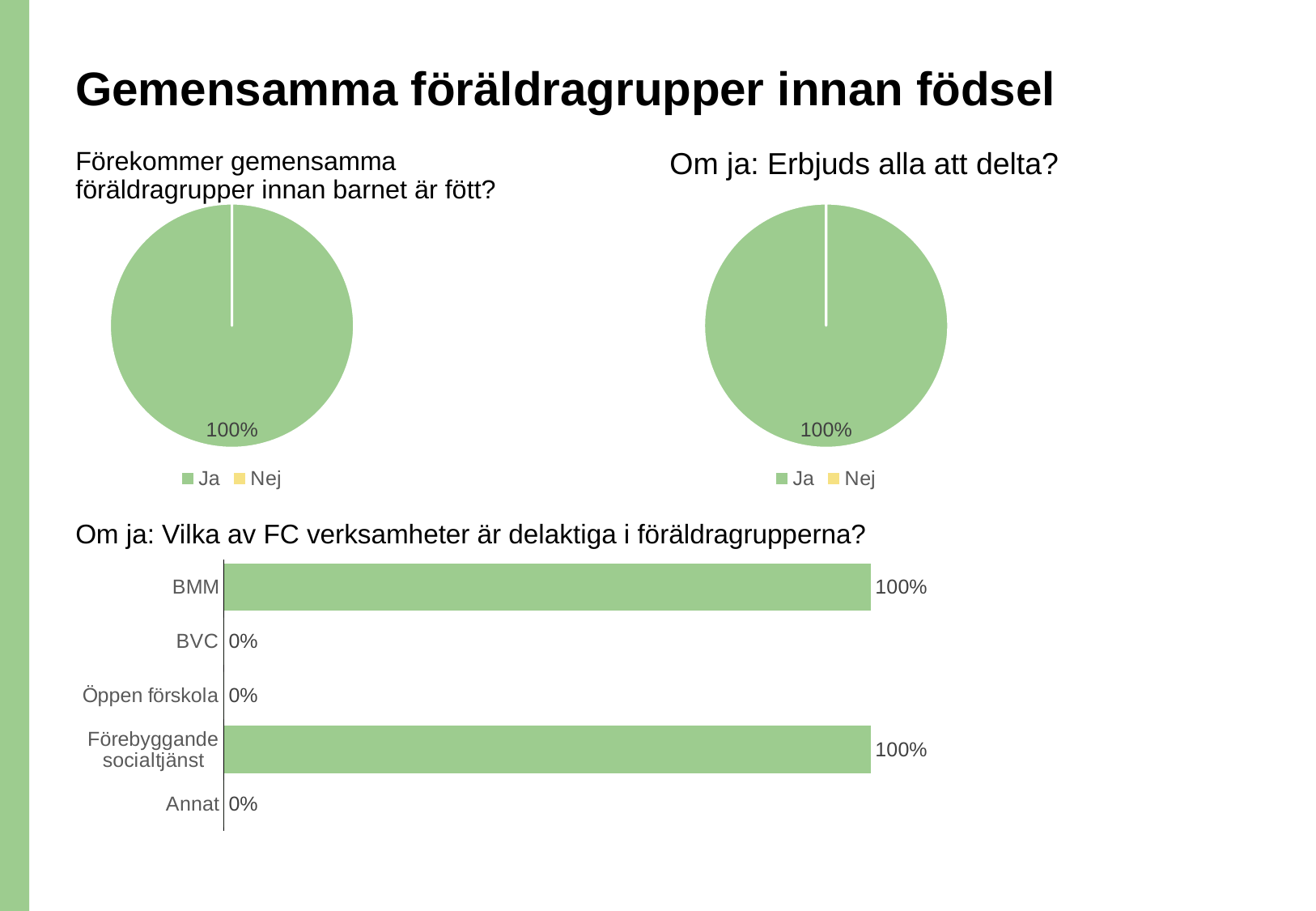
In the bar chart titled 'Om ja: Vilka av FC verksamheter är delaktiga i föräldragrupperna?', what is the value for BVC? 0% In the bar chart titled 'Om ja: Vilka av FC verksamheter är delaktiga i föräldragrupperna?', what is the value for BMM? 100% In the bar chart titled 'Om ja: Vilka av FC verksamheter är delaktiga i föräldragrupperna?', which is larger, BMM or Annat? BMM What kind of chart is the chart titled 'Om ja: Vilka av FC verksamheter är delaktiga i föräldragrupperna?'? Bar chart In the bar chart titled 'Om ja: Vilka av FC verksamheter är delaktiga i föräldragrupperna?', what is the difference between BMM and Öppen förskola? 100% What kind of chart is the chart titled 'Förekommer gemensamma föräldragrupper innan barnet är fött?'? Pie chart In the pie chart titled 'Förekommer gemensamma föräldragrupper innan barnet är fött?', what are the legend entries? Ja, Nej In the pie chart titled 'Om ja: Erbjuds alla att delta?', what share does 'Ja' have? 100% How many series does the legend list in the pie chart titled 'Om ja: Erbjuds alla att delta?'? 2 In the bar chart titled 'Om ja: Vilka av FC verksamheter är delaktiga i föräldragrupperna?', how many categories are shown? 5 In the pie chart titled 'Förekommer gemensamma föräldragrupper innan barnet är fött?', what share does 'Ja' have? 100% In the bar chart titled 'Om ja: Vilka av FC verksamheter är delaktiga i föräldragrupperna?', what is the value for Förebyggande socialtjänst? 100%